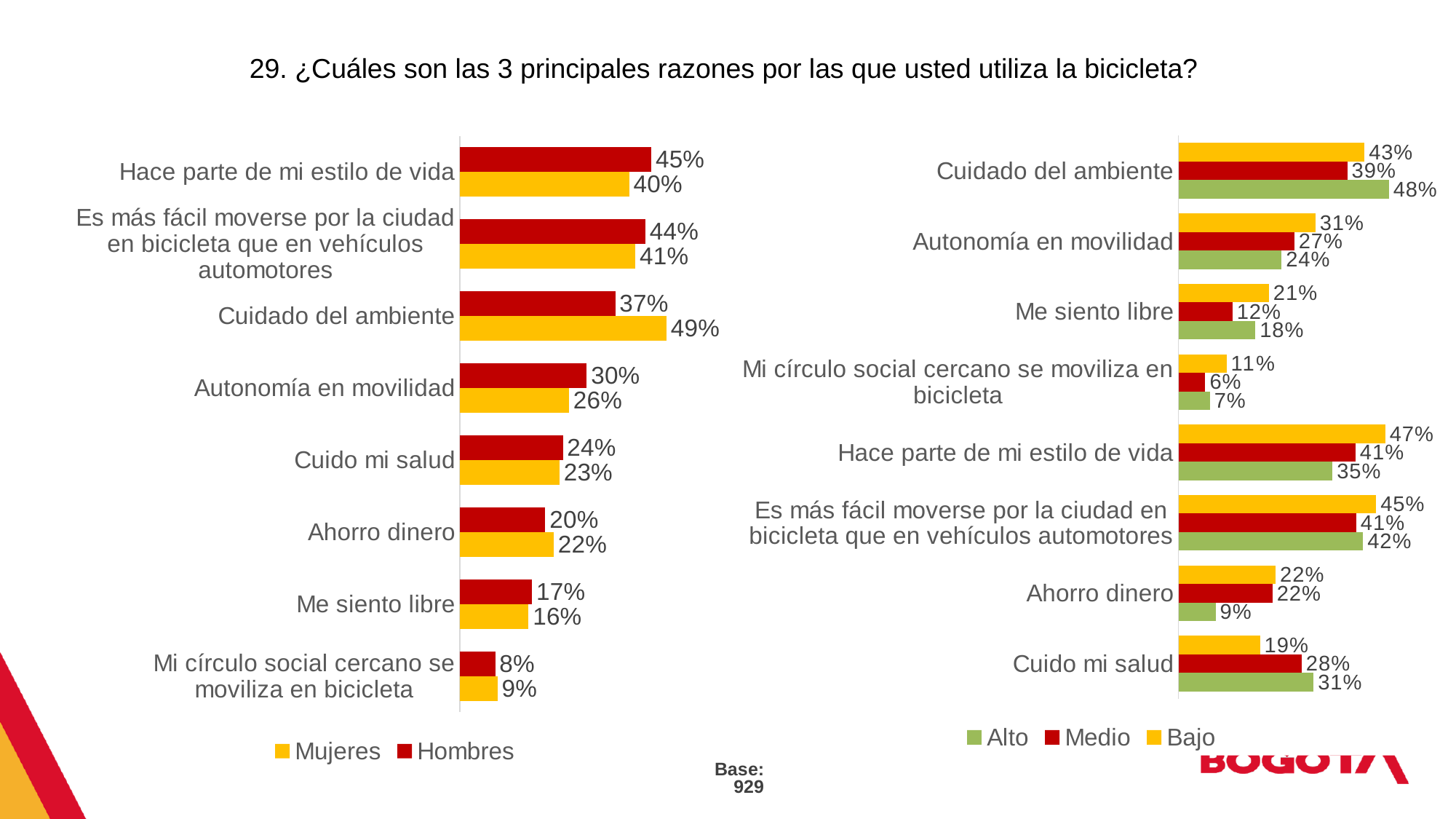
In the right chart (Alto/Medio/Bajo), which is larger for 'Ahorro dinero': the Alto value or the Bajo value? Bajo In the right chart (Alto/Medio/Bajo), what is the value for Medio for 'Cuido mi salud'? 28% In the left chart (Mujeres/Hombres), what is the difference between the Hombres and Mujeres values for 'Cuidado del ambiente'? 12% In the left chart (Mujeres/Hombres), how many categories are shown? 8 In the right chart (Alto/Medio/Bajo), what is the difference between the Bajo and Medio values for 'Me siento libre'? 9% In the right chart (Alto/Medio/Bajo), what is the value for Alto for 'Cuidado del ambiente'? 48% What kind of chart is used on this slide? Bar chart In the left chart (Mujeres/Hombres), which category has the lowest value for Hombres? Mi círculo social cercano se moviliza en bicicleta In the right chart (Alto/Medio/Bajo), which category has the highest value for Bajo? Hace parte de mi estilo de vida In the left chart (Mujeres/Hombres), what is the value for Mujeres for 'Cuidado del ambiente'? 49% In the left chart (Mujeres/Hombres), how many series does the legend list? 2 In the left chart (Mujeres/Hombres), what is the value for Hombres for 'Autonomía en movilidad'? 30%